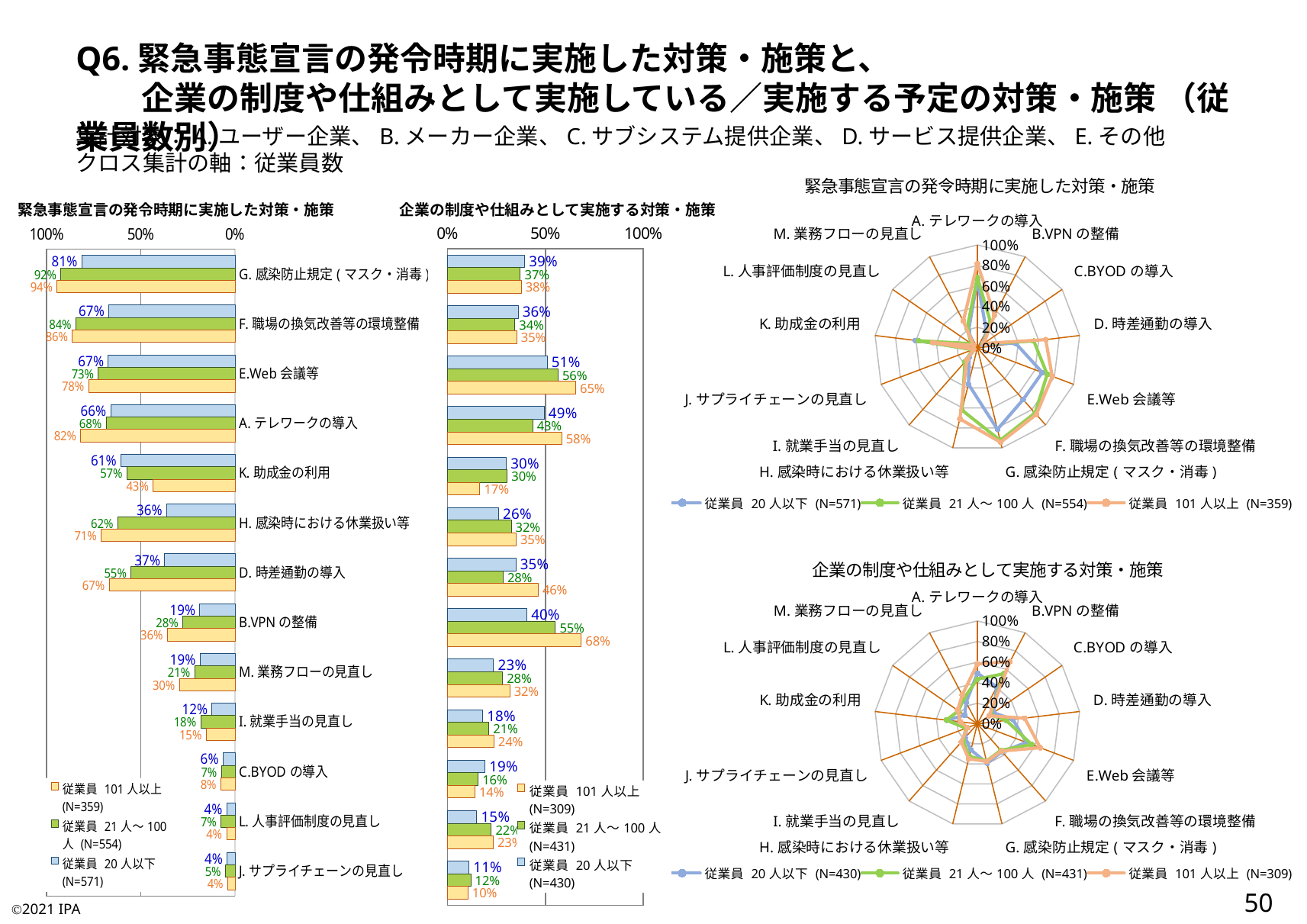
In the left bar chart titled 緊急事態宣言の発令時期に実施した対策・施策, what is the value for G. 感染防止規定(マスク・消毒) for 従業員 101人以上? 94% In the middle bar chart titled 企業の制度や仕組みとして実施する対策・施策, what is the difference between the 従業員 20人以下 and 従業員 101人以上 values for K. 助成金の利用? 13% What kind of chart is the chart at the top right titled 緊急事態宣言の発令時期に実施した対策・施策? Radar chart In the left bar chart titled 緊急事態宣言の発令時期に実施した対策・施策, what is the difference between the 従業員 101人以上 and 従業員 20人以下 values for A. テレワークの導入? 16% In the left bar chart titled 緊急事態宣言の発令時期に実施した対策・施策, which is larger for H. 感染時における休業扱い等: the value for 従業員 20人以下 or for 従業員 101人以上? 従業員 101人以上 In the left bar chart titled 緊急事態宣言の発令時期に実施した対策・施策, what is the value for K. 助成金の利用 for 従業員 20人以下? 61% How many categories are shown in the middle bar chart titled 企業の制度や仕組みとして実施する対策・施策? 13 How many series does the legend of the left bar chart titled 緊急事態宣言の発令時期に実施した対策・施策 list? 3 In the middle bar chart titled 企業の制度や仕組みとして実施する対策・施策, what is the value for B.VPNの整備 for 従業員 101人以上? 68% In the left bar chart titled 緊急事態宣言の発令時期に実施した対策・施策, which category has the highest value for 従業員 21人〜100人? G. 感染防止規定(マスク・消毒) In the middle bar chart titled 企業の制度や仕組みとして実施する対策・施策, which category has the lowest value for 従業員 101人以上? J. サプライチェーンの見直し In the middle bar chart titled 企業の制度や仕組みとして実施する対策・施策, what is the value for E.Web会議等 for 従業員 21人〜100人? 56%